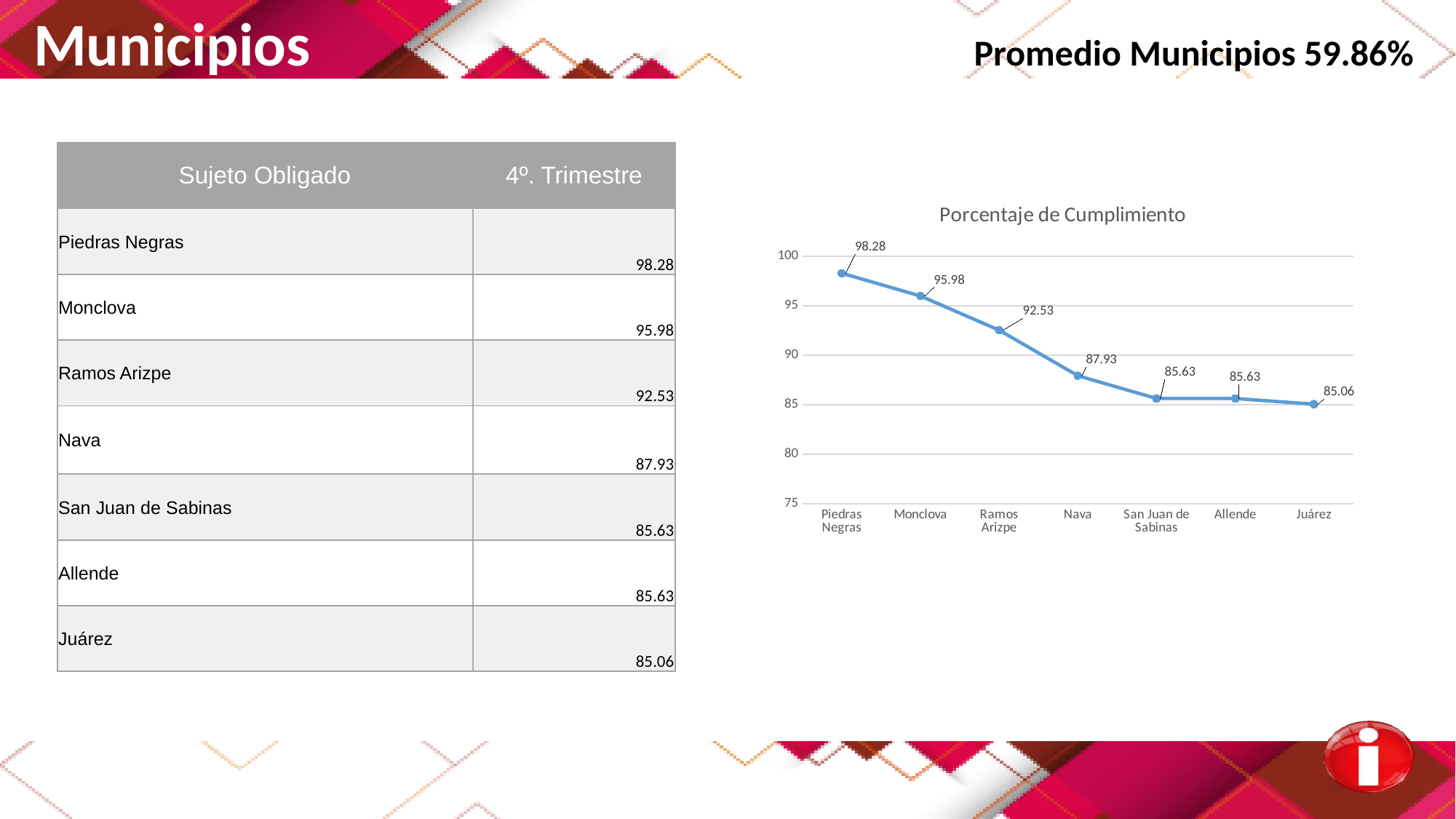
Which municipality has the highest value in the Porcentaje de Cumplimiento chart? Piedras Negras Do the values in the Porcentaje de Cumplimiento chart rise or fall from Piedras Negras to Juárez? fall What is the difference between the values for Ramos Arizpe and Nava in the Porcentaje de Cumplimiento chart? 4.60 What is the value for Piedras Negras in the Porcentaje de Cumplimiento chart? 98.28 What is the value for Nava in the Porcentaje de Cumplimiento chart? 87.93 What is the value for Juárez in the Porcentaje de Cumplimiento chart? 85.06 Which municipality has the lowest value in the Porcentaje de Cumplimiento chart? Juárez How many municipalities are plotted in the Porcentaje de Cumplimiento chart? 7 What is the difference between the values for Piedras Negras and Monclova in the Porcentaje de Cumplimiento chart? 2.30 Which is larger in the Porcentaje de Cumplimiento chart, the value for Monclova or the value for Nava? Monclova Is the value for Ramos Arizpe in the Porcentaje de Cumplimiento chart greater or less than 90? greater What kind of chart is the Porcentaje de Cumplimiento chart? line chart